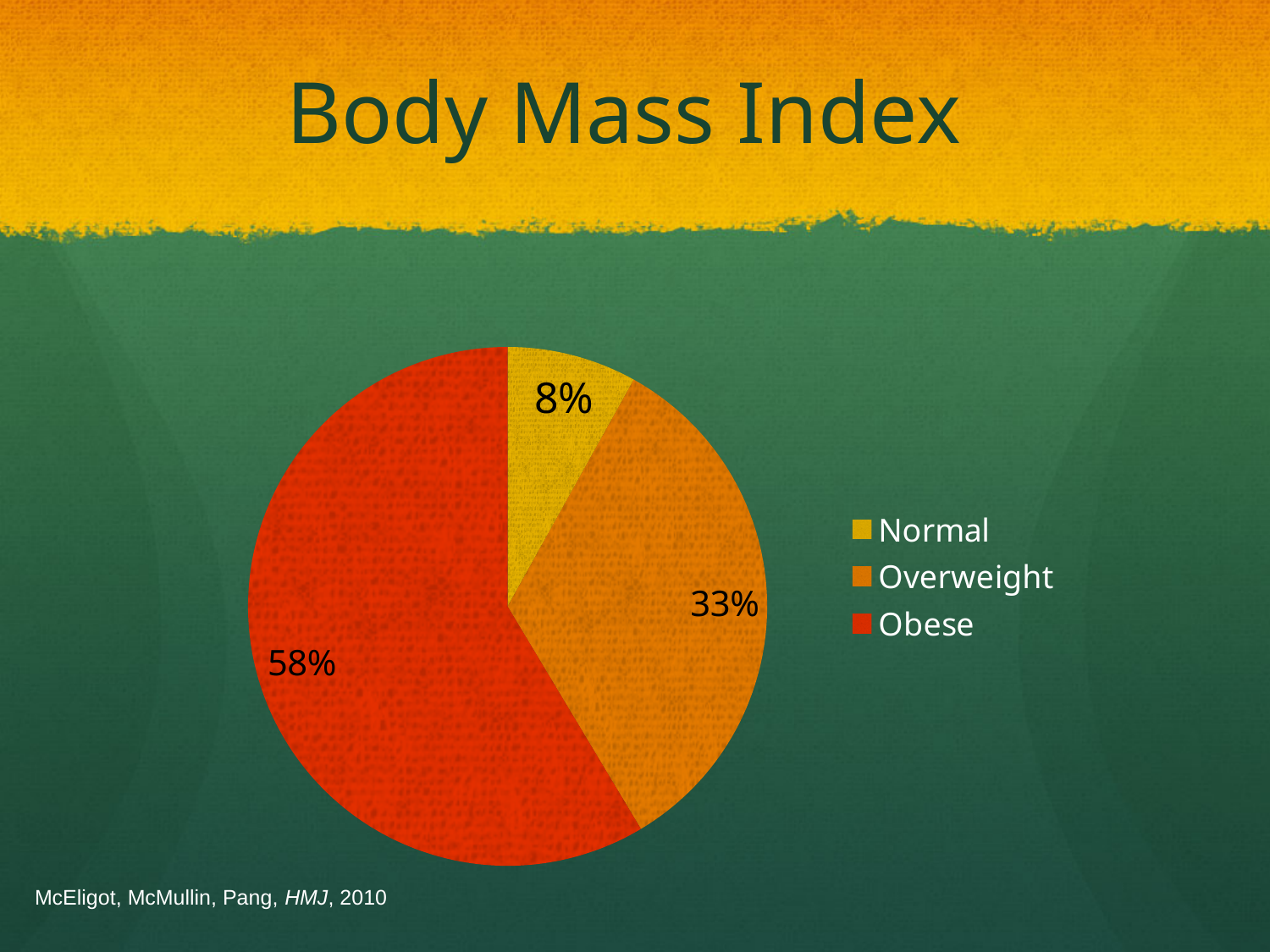
How many categories does the pie chart show? 3 What kind of chart is shown on the slide? pie chart What share of the pie is labelled Normal? 8% What share of the pie is labelled Obese? 58% Which category has the largest slice of the pie? Obese What is the difference in percentage points between the Obese and Overweight slices? 25 Which colour represents the Obese category in the legend? red What is the difference in percentage points between the Overweight and Normal slices? 25 What share of the pie is labelled Overweight? 33% What is the title of the slide containing the chart? Body Mass Index Which slice is larger, Overweight or Normal? Overweight Which category has the smallest slice of the pie? Normal